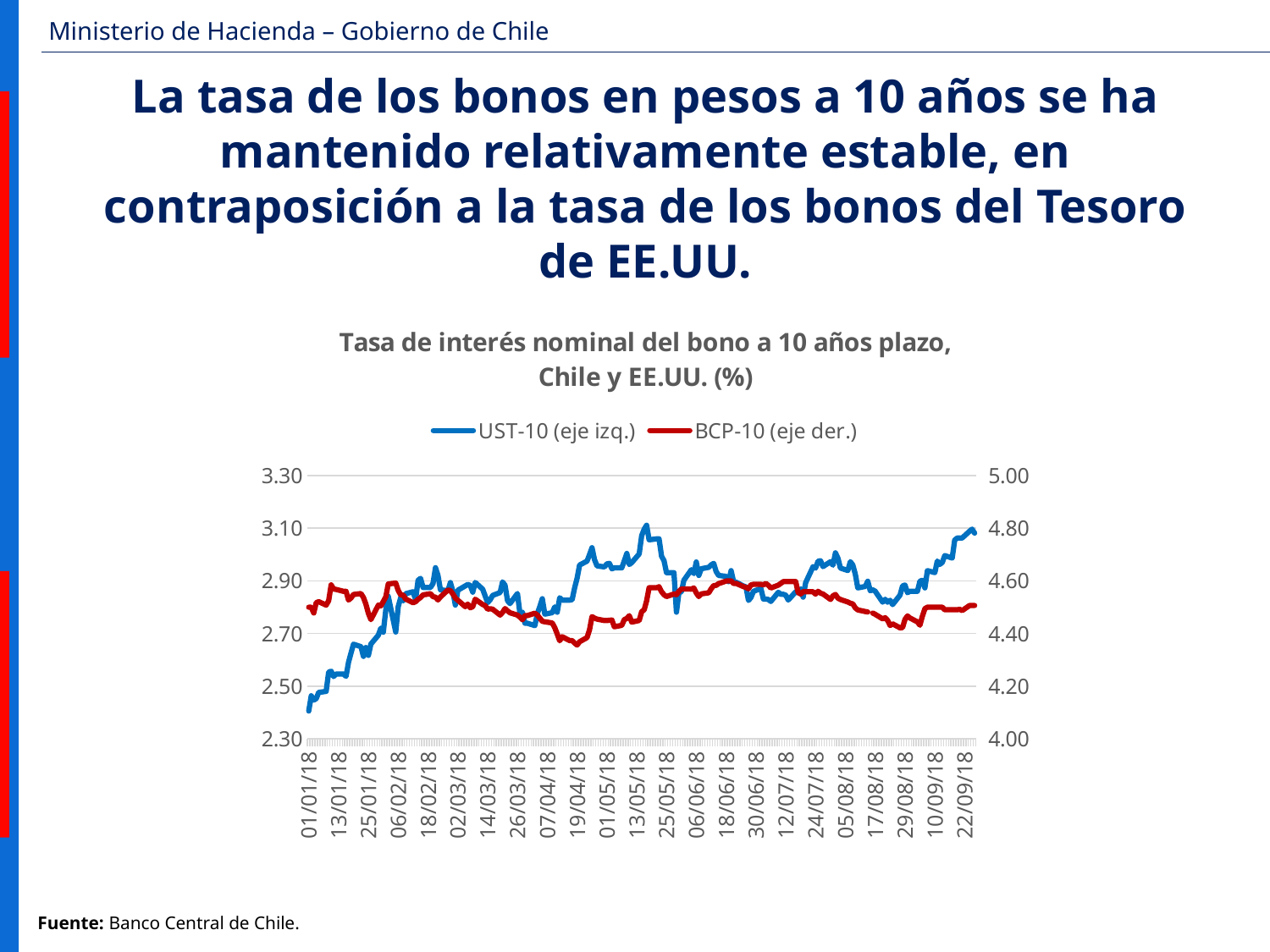
Does the BCP-10 series rise or fall between 18/06/18 and 29/08/18? fall What is the title of the chart? Tasa de interés nominal del bono a 10 años plazo, Chile y EE.UU. (%) Does the UST-10 series end higher or lower on 22/09/18 than it started on 01/01/18? higher Is the value of UST-10 on 22/09/18 greater or less than 2.90? greater Is the value of BCP-10 on 22/09/18 greater or less than 4.60? less What kind of chart is shown on the slide? line chart Is the value of UST-10 on 01/01/18 greater or less than 2.50? less Which series is plotted against the right-hand axis according to the legend? BCP-10 (eje der.) How many series does the legend list? 2 Does the UST-10 series rise or fall between 01/01/18 and 13/01/18? rise